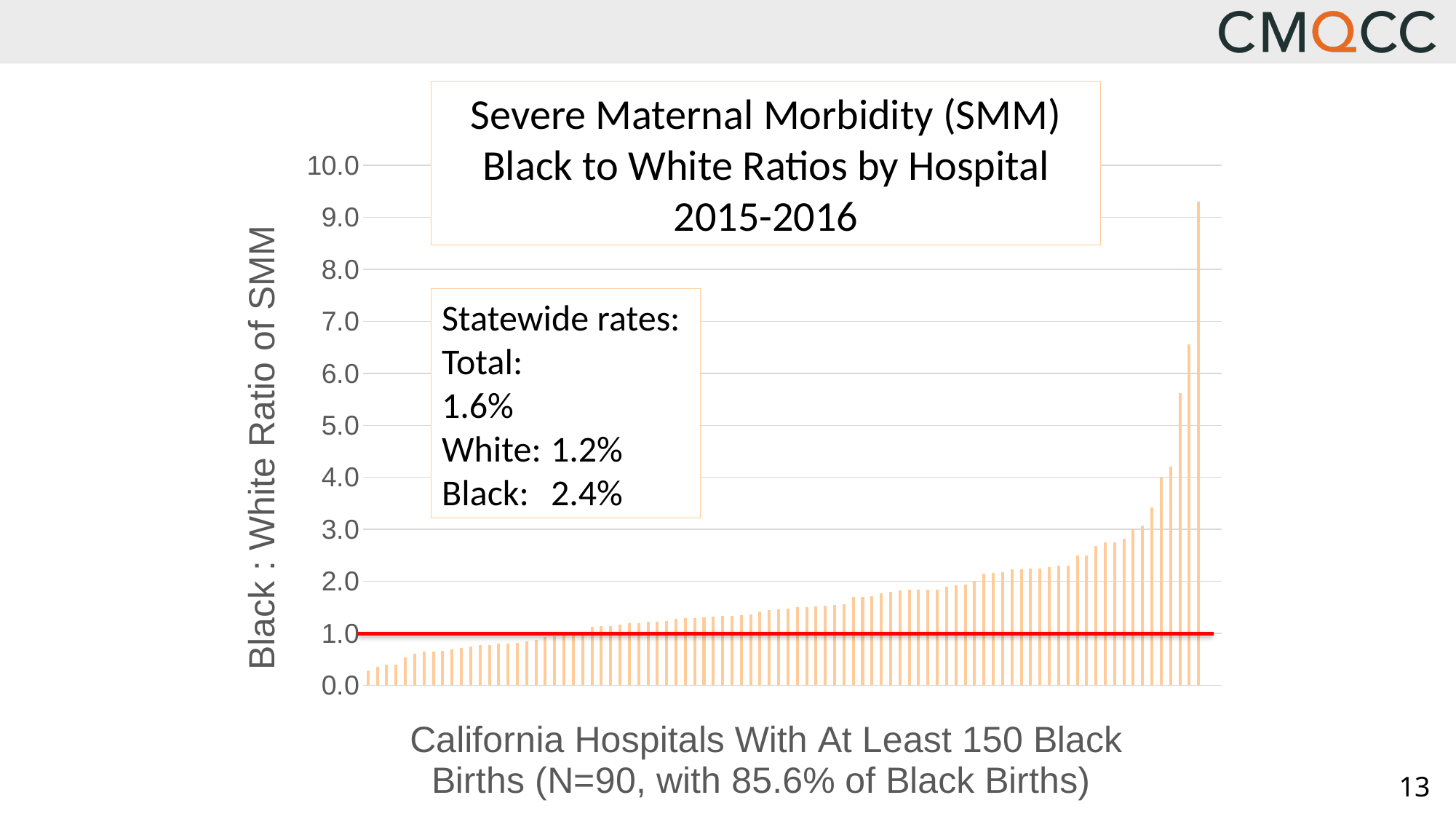
What is the title of the chart? Severe Maternal Morbidity (SMM) Black to White Ratios by Hospital 2015-2016 How many hospitals are plotted in the chart? 90 What is the statewide SMM rate for Black births shown on the chart? 2.4% Is the value of the tallest bar greater or less than 9.0? greater What percentage of Black births do the plotted hospitals account for, according to the x-axis label? 85.6% Is the value of the second-tallest bar greater or less than 6.0? greater What is the statewide total SMM rate shown in the text box on the chart? 1.6% What is the label on the y axis? Black : White Ratio of SMM What kind of chart is shown on the slide? bar chart Is the value of the shortest bar (leftmost) greater or less than 1.0? less Do the bar values rise or fall from left to right along the x axis? rise What is the statewide SMM rate for White births shown on the chart? 1.2%